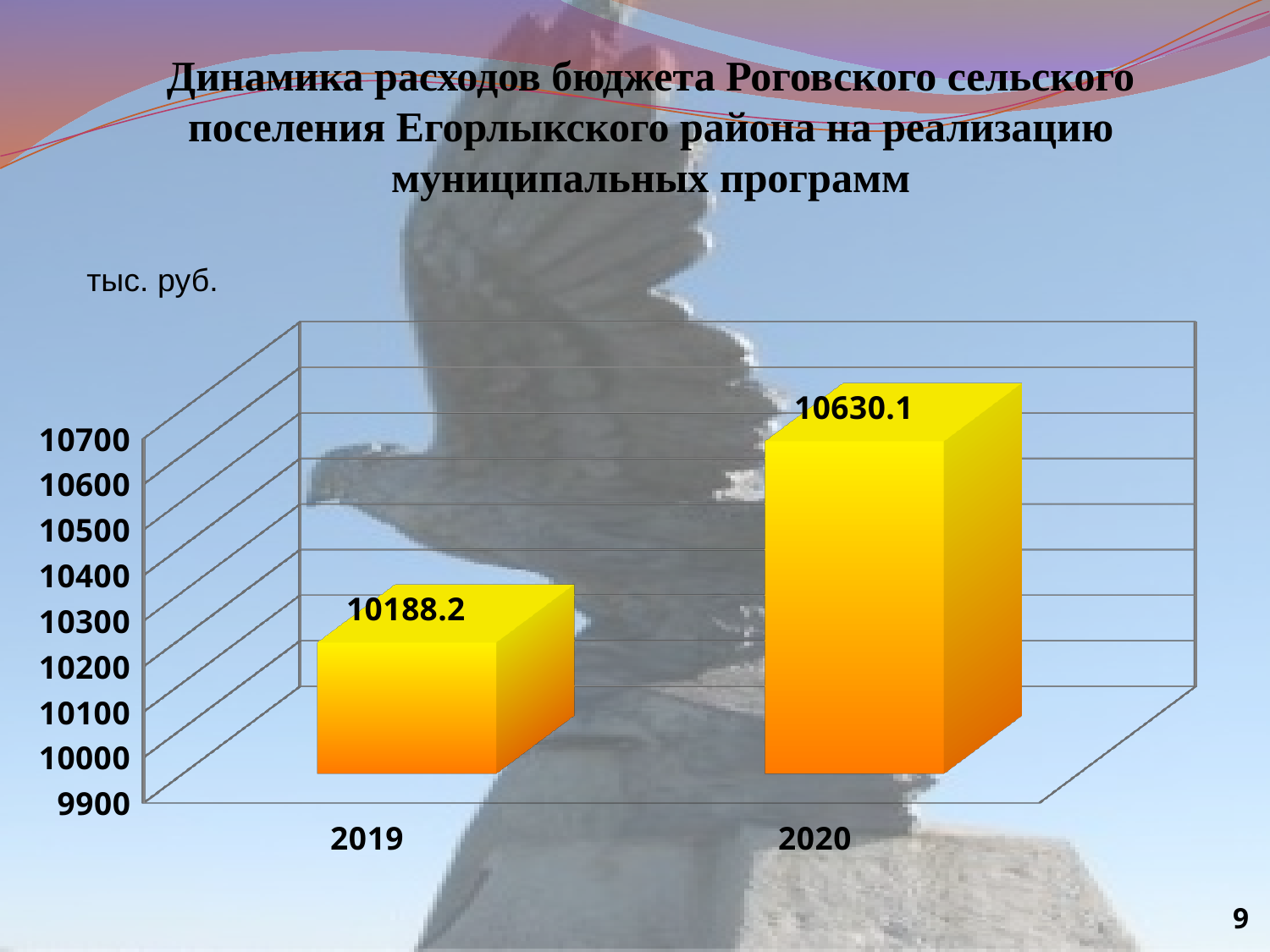
Is the value for 2020 greater or less than 10500? greater Which year has the highest value? 2020 What is the value for 2019? 10188.2 What kind of chart is shown on the slide? bar chart Is the value for 2019 greater or less than 10300? less Do the values rise or fall from 2019 to 2020? rise How many years are shown on the chart? 2 Which is larger, the value for 2019 or the value for 2020? 2020 Which year has the lowest value? 2019 What is the value for 2020? 10630.1 What unit is indicated above the chart? тыс. руб. What is the difference between the values for 2020 and 2019? 441.9